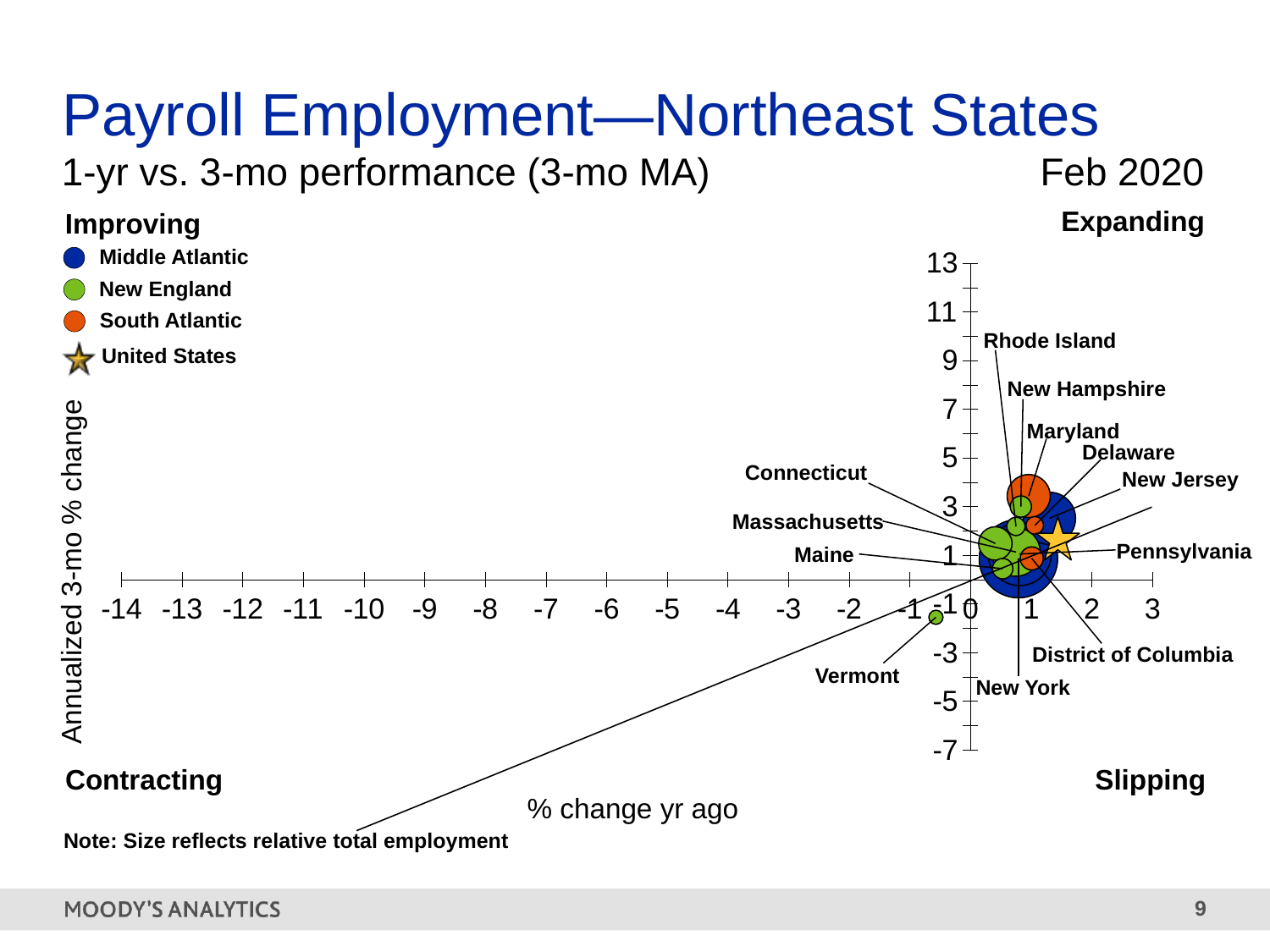
How many series does the legend list? 4 Which legend series is shown in green? New England Which has a higher annualized 3-mo % change, Maryland or Vermont? Maryland What kind of chart is shown on the slide? Bubble chart (scatter plot) Is the annualized 3-mo % change for Maryland greater or less than 1? greater Is the % change yr ago for Vermont greater or less than 0? less Is the % change yr ago for New Jersey greater or less than 1? greater Which labeled state has the lowest annualized 3-mo % change? Vermont How many states or districts are labeled on the chart? 12 Which labeled state has the lowest % change yr ago (furthest left on the x axis)? Vermont What is the label on the x axis of the chart? % change yr ago